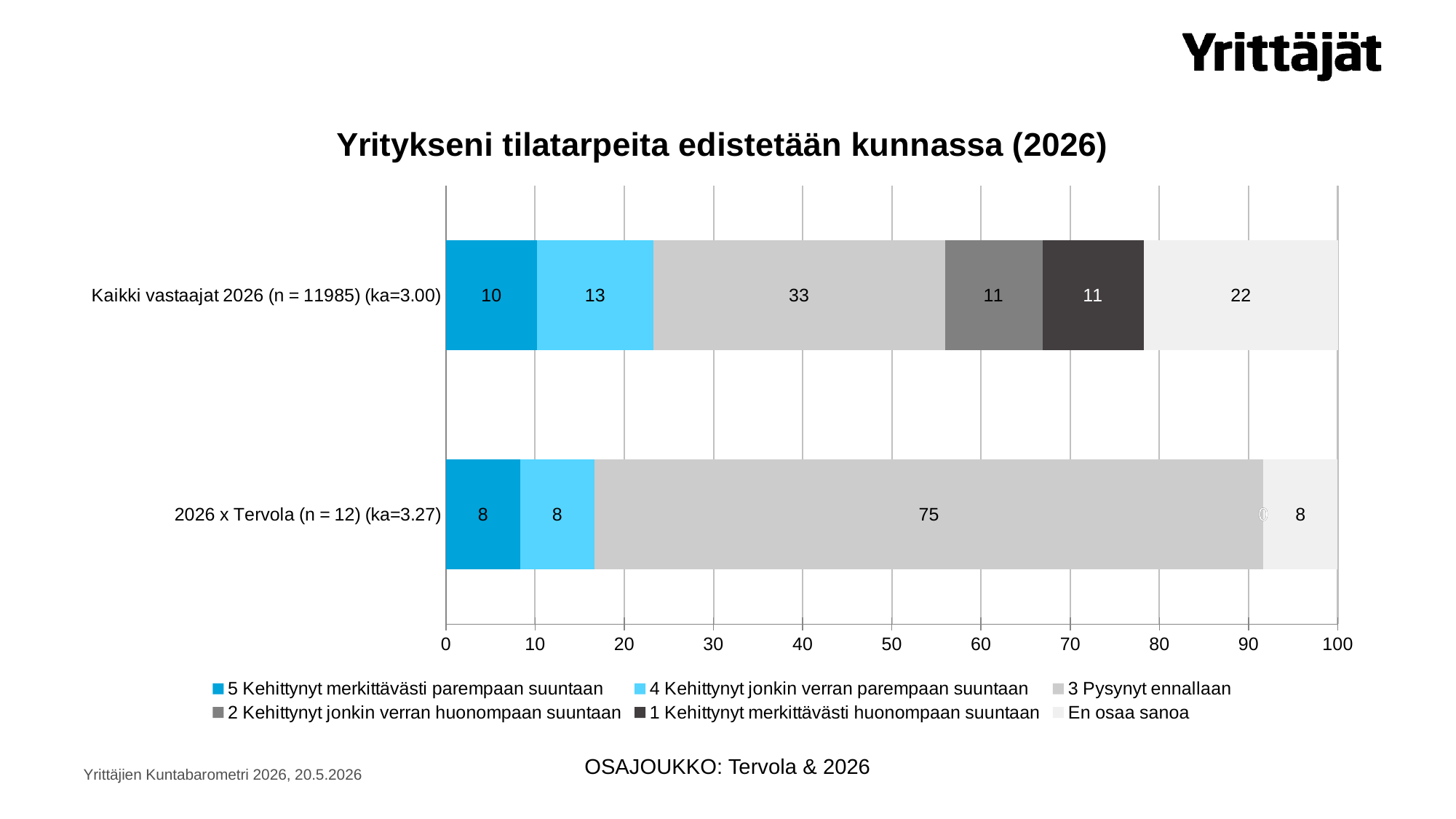
What is the value of '3 Pysynyt ennallaan' for 'Kaikki vastaajat 2026 (n = 11985) (ka=3.00)'? 33 What is the value of 'En osaa sanoa' for 'Kaikki vastaajat 2026 (n = 11985) (ka=3.00)'? 22 How many series does the legend list? 6 What is the total of the stacked bar for 'Kaikki vastaajat 2026 (n = 11985) (ka=3.00)'? 100 What is the value of '5 Kehittynyt merkittävästi parempaan suuntaan' for '2026 x Tervola (n = 12) (ka=3.27)'? 8 What is the value of '3 Pysynyt ennallaan' for '2026 x Tervola (n = 12) (ka=3.27)'? 75 How many categories (bars) are shown in the chart? 2 What is the difference between the '3 Pysynyt ennallaan' values for '2026 x Tervola' and 'Kaikki vastaajat 2026'? 42 What is the value of '4 Kehittynyt jonkin verran parempaan suuntaan' for 'Kaikki vastaajat 2026 (n = 11985) (ka=3.00)'? 13 What type of chart is shown on the slide? Stacked bar chart What is the title of the chart? Yritykseni tilatarpeita edistetään kunnassa (2026) Which category has the larger value for 'En osaa sanoa': 'Kaikki vastaajat 2026' or '2026 x Tervola'? Kaikki vastaajat 2026 (n = 11985) (ka=3.00)